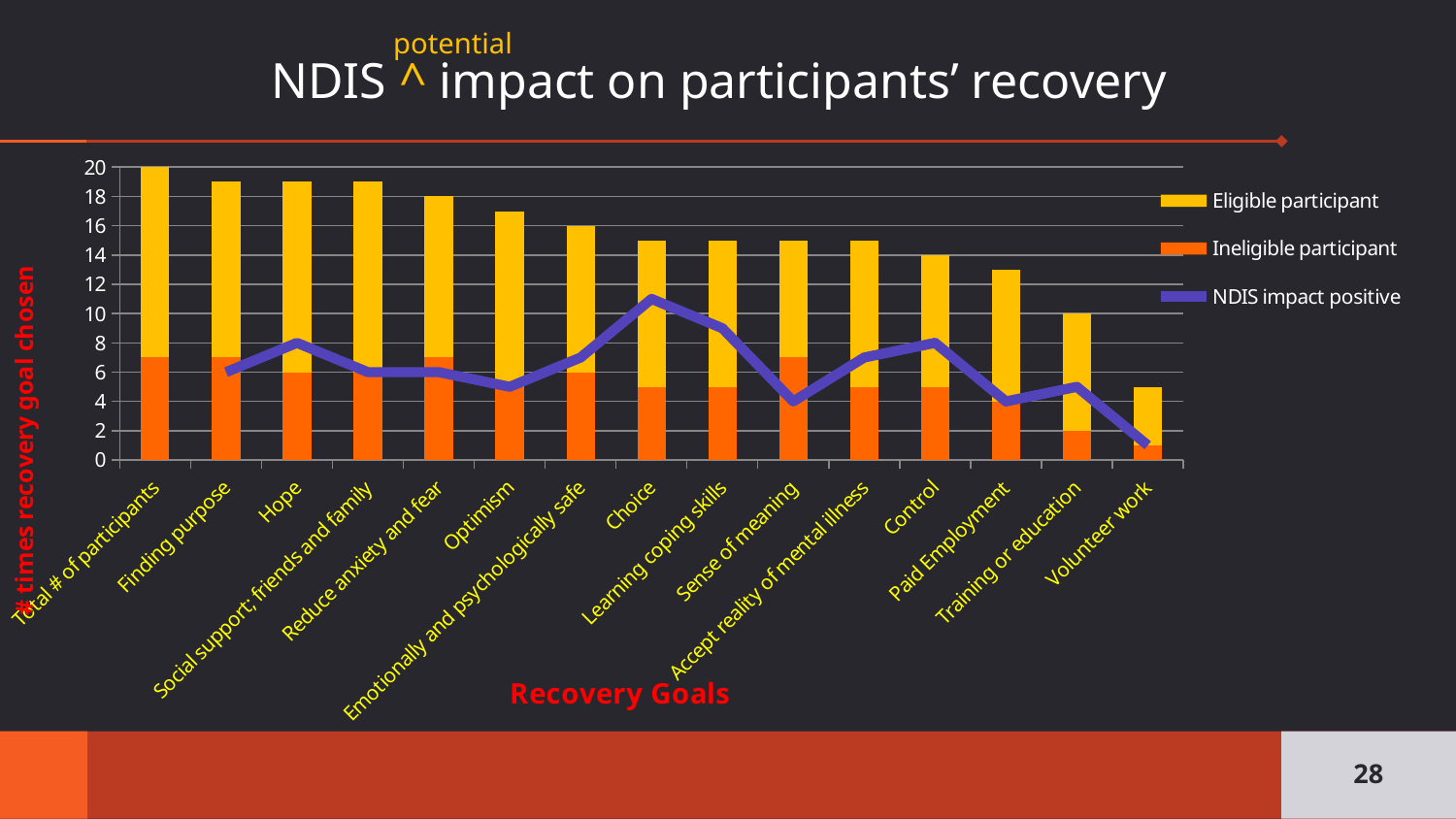
Is the NDIS impact positive value for Volunteer work greater or less than 2? less Which category has the tallest stacked bar? Total # of participants Is the total stacked bar for Paid Employment greater or less than 12? greater Do the stacked bar totals generally rise or fall moving left to right along the x axis? fall What is the title of the x axis? Recovery Goals What is the total height of the stacked bar for Total # of participants? 20 How many series does the legend list? 3 What kind of chart is shown on the slide? Stacked bar chart with a line Is the total stacked bar for Volunteer work greater or less than 6? less How many recovery goal categories are shown on the x axis? 15 Which category has the shortest stacked bar? Volunteer work Which has a taller stacked bar, Total # of participants or Volunteer work? Total # of participants